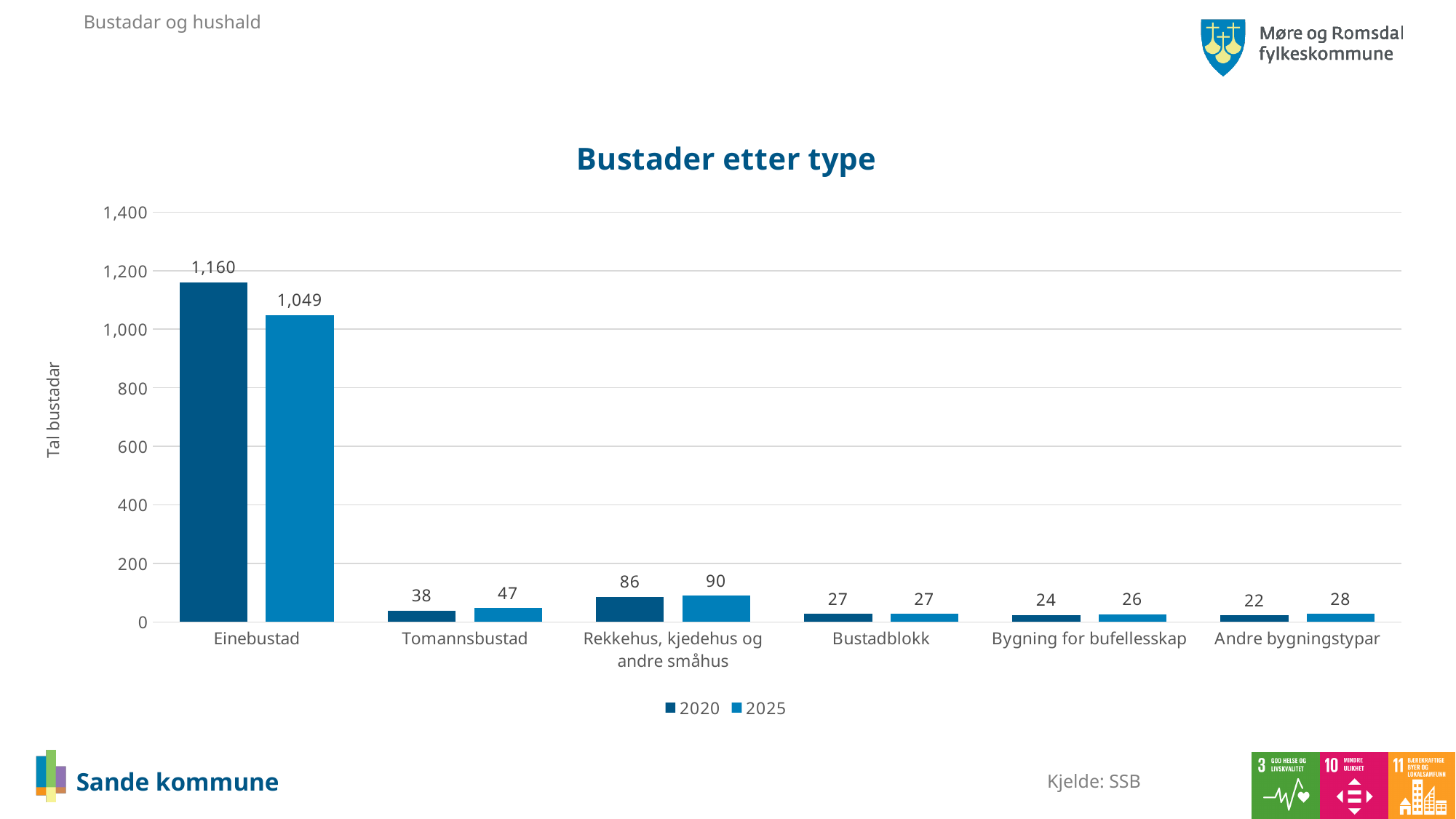
How many series does the legend list? 2 Which is larger for Bygning for bufellesskap: the 2020 value or the 2025 value? 2025 What is the value for Einebustad in 2020? 1,160 How many categories are shown on the x axis? 6 What is the value for Rekkehus, kjedehus og andre småhus in 2025? 90 What is the value for Tomannsbustad in 2020? 38 What is the difference between the 2020 and 2025 values for Einebustad? 111 What kind of chart is shown on the slide? Bar chart What is the difference between the 2025 and 2020 values for Tomannsbustad? 9 Which category has the highest value in 2020? Einebustad Which category has the lowest value in 2020? Andre bygningstypar What is the value for Einebustad in 2025? 1,049